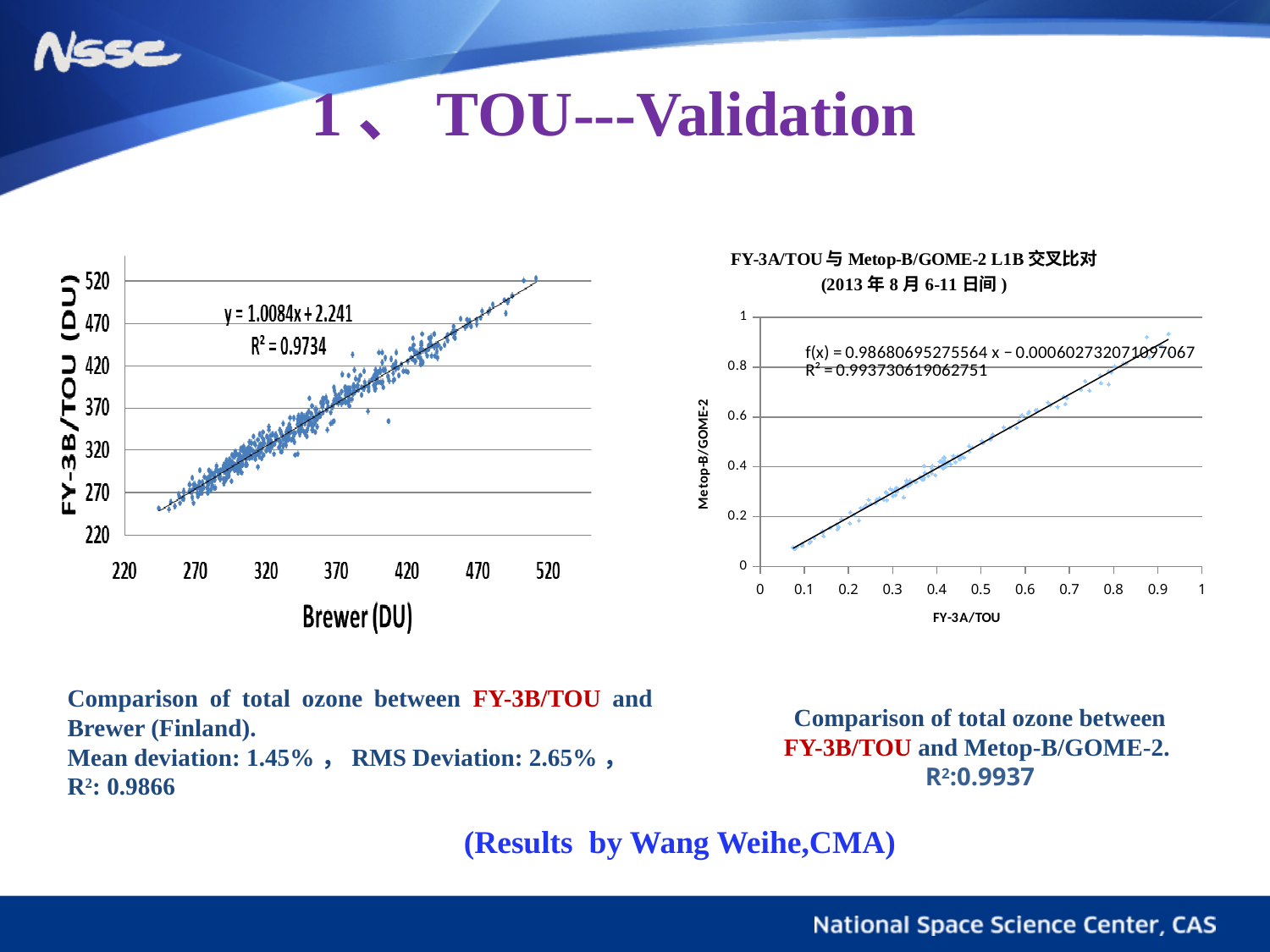
What is the y-axis label of the left chart? FY-3B/TOU (DU) On the right chart, what R² value is printed inside the plot area? R² = 0.993730619062751 On the left chart, what is the fitted regression equation shown? y = 1.0084x + 2.241 On the left chart, do the FY-3B/TOU values rise or fall as Brewer (DU) increases? rise On the left chart, what R² value is printed? R² = 0.9734 What kind of chart is the right chart with FY-3A/TOU on the x axis? scatter chart What is the x-axis label of the right chart? FY-3A/TOU On the right chart, what is the highest tick value shown on the x axis? 1 On the right chart, do the Metop-B/GOME-2 values rise or fall as FY-3A/TOU increases? rise On the left chart, what is the highest tick value shown on the y axis? 520 What kind of chart is the left chart with Brewer (DU) on the x axis? scatter chart On the right chart, what is the slope of the fitted line f(x) shown? 0.98680695275564